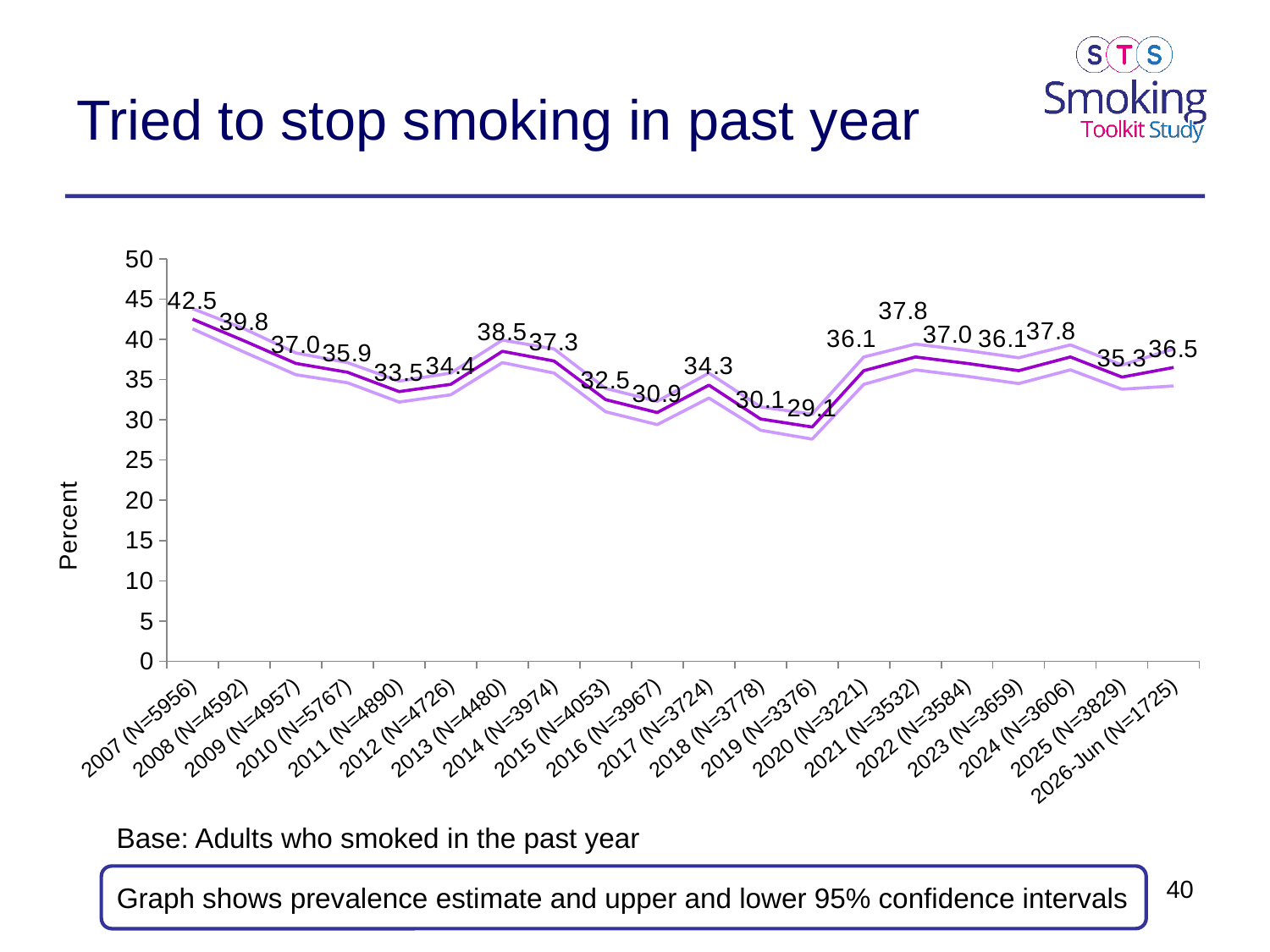
What kind of chart is shown on the slide? line chart What is the difference between the values for 2007 (N=5956) and 2019 (N=3376)? 13.4 Which year has the lowest estimate? 2019 (N=3376) How many years are plotted on the x axis? 20 What is the value for 2019 (N=3376)? 29.1 Does the estimate rise or fall from 2019 (N=3376) to 2020 (N=3221)? rise Which is larger, the value for 2017 (N=3724) or the value for 2018 (N=3778)? 2017 (N=3724) What is the value for 2007 (N=5956)? 42.5 What is the value for 2013 (N=4480)? 38.5 What is the label of the y axis? Percent Which year has the highest estimate? 2007 (N=5956) What is the value for 2026-Jun (N=1725)? 36.5